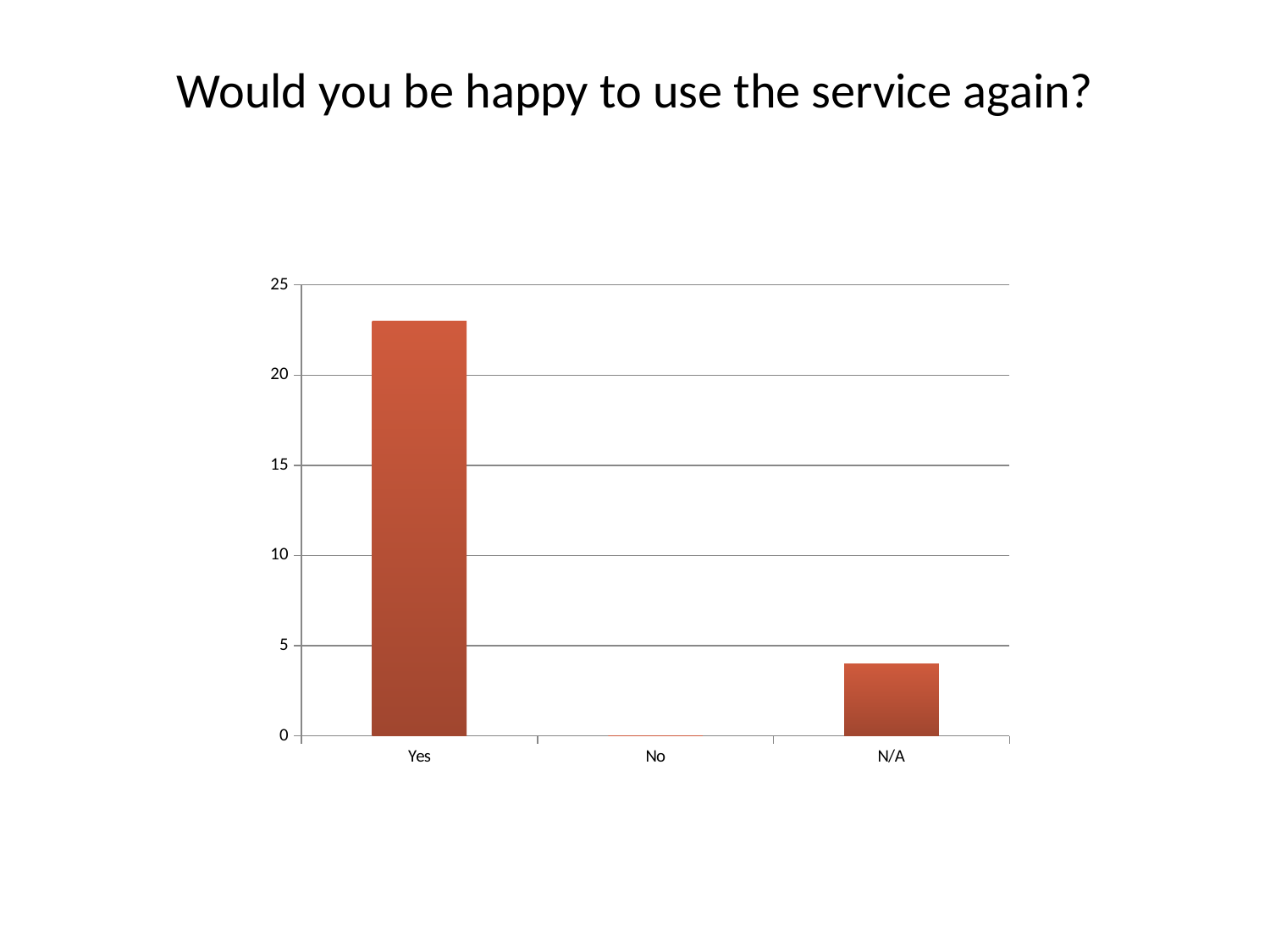
What is the title of the slide above the chart? Would you be happy to use the service again? Is the value for Yes greater or less than 15? greater How many categories are shown on the x axis of the chart? 3 Is the value for N/A greater or less than 10? less Is the value for N/A greater or less than 5? less Which category has the lowest value in the chart? No What kind of chart is shown on the slide? bar chart What is the value for No in the chart? 0 Which is larger, the value for Yes or the value for N/A? Yes What is the highest value shown on the vertical axis of the chart? 25 Which category has the highest value in the chart? Yes